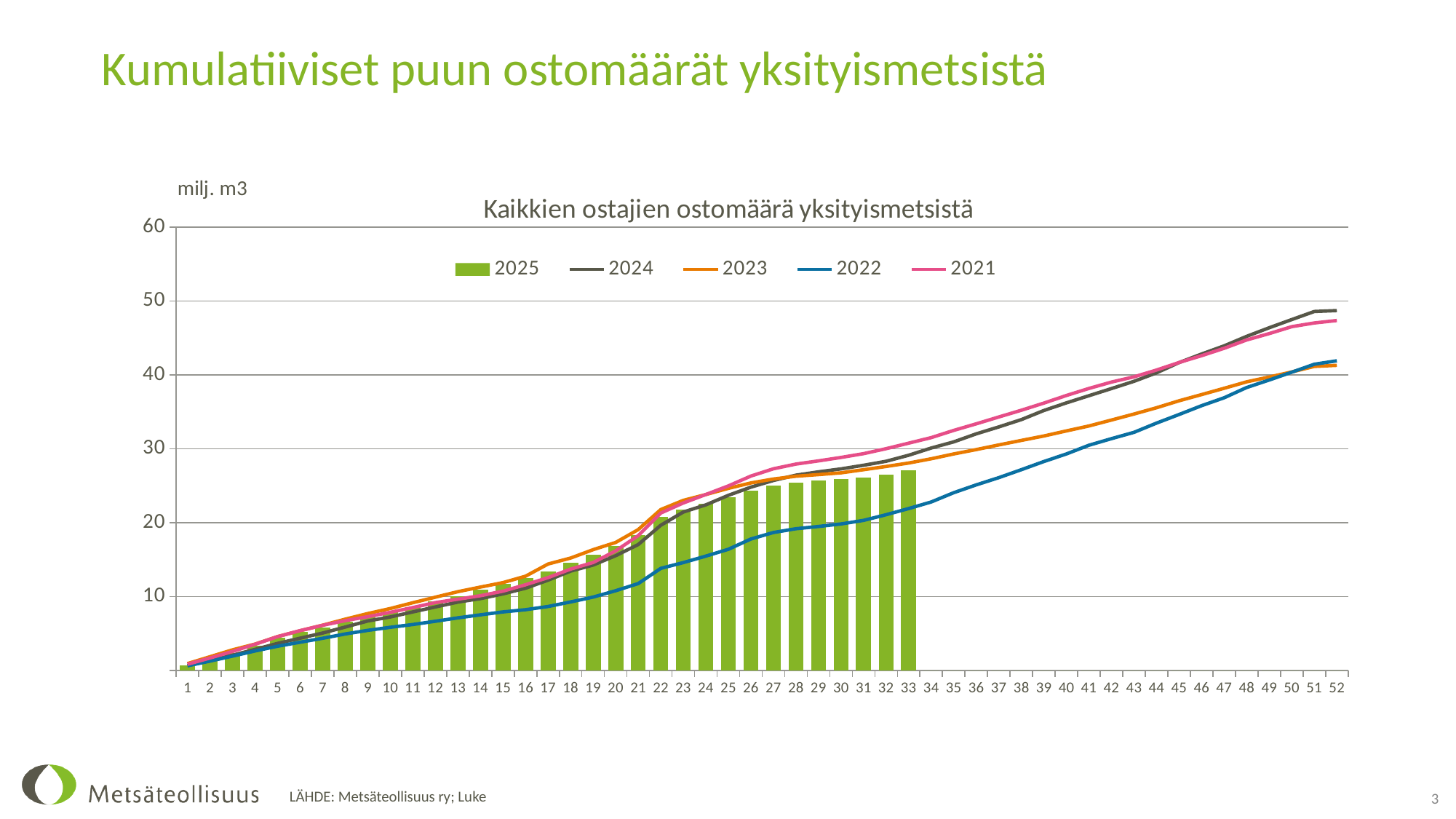
What is the title of the chart? Kaikkien ostajien ostomäärä yksityismetsistä Is the value for 2025 at week 33 greater or less than 30? less How many bars does the 2025 series have in the chart? 33 Do the values of the 2024 series rise or fall along the x axis? rise Is the value for 2022 at week 52 greater or less than 50? less How many series does the chart legend list? 5 What kind of chart is used for the 2025 series? bar chart How many weeks are shown on the x axis of the chart? 52 At week 52, which series is higher, 2024 or 2023? 2024 Is the value for 2024 at week 52 greater or less than 40? greater Which series has the lowest value at week 40? 2022 What kind of chart is used for the 2024 series? line chart